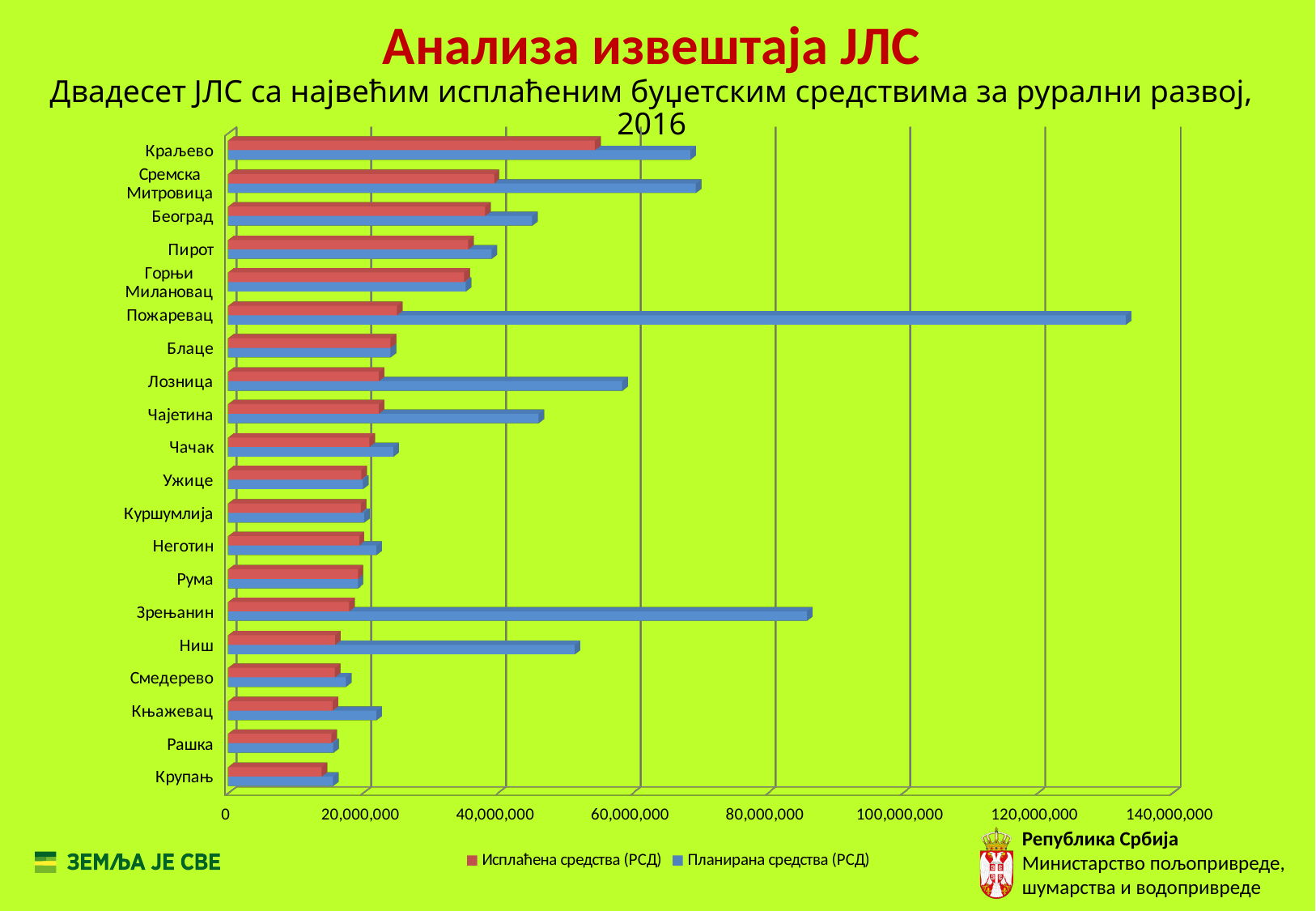
What kind of chart is shown on the slide? bar chart Is the Планирана средства (РСД) value for Пожаревац greater or less than 120,000,000? greater How many local self-government units (categories) are shown in the chart? 20 Which category has the highest value for Планирана средства (РСД)? Пожаревац Is the Планирана средства (РСД) value for Зрењанин greater or less than 80,000,000? greater What year is given in the chart title? 2016 Which category has the highest value for Исплаћена средства (РСД)? Краљево Which has the larger Планирана средства (РСД) value, Лозница or Ниш? Лозница How many series does the legend list? 2 Is the Исплаћена средства (РСД) value for Краљево greater or less than 40,000,000? greater Which series is shown in red in the chart? Исплаћена средства (РСД)